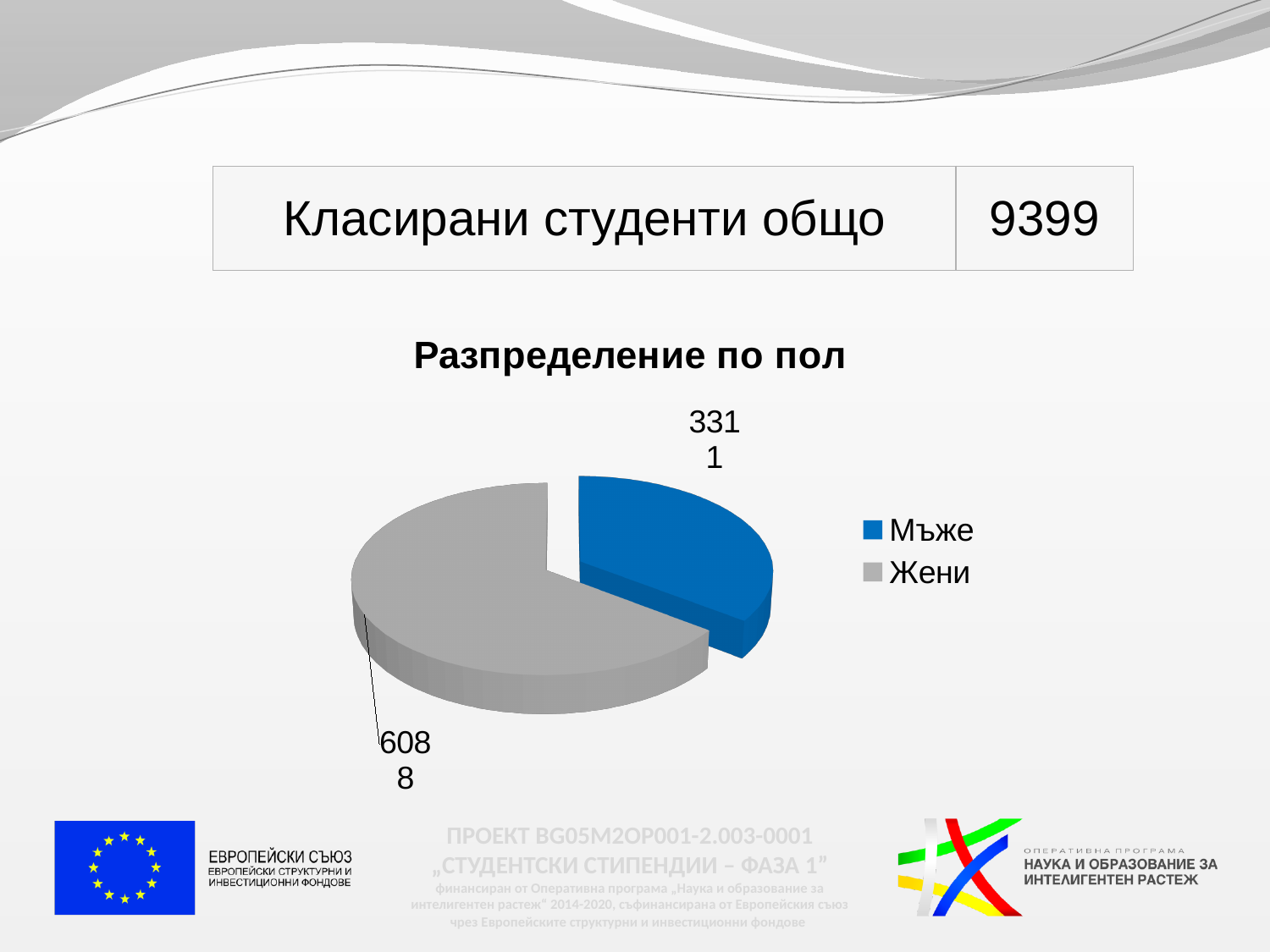
How many slices does the pie chart have? 2 How many categories does the legend of the chart list? 2 What type of chart is shown on the slide? pie chart What is the value for Мъже in the chart? 3311 What is the value for Жени in the chart? 6088 Which category has the smallest slice in the chart? Мъже Which is larger, the value for Мъже or the value for Жени? Жени Which category has the largest slice in the chart? Жени What is the difference between the values for Жени and Мъже? 2777 What is the title of the chart? Разпределение по пол Which colour represents Мъже in the chart? blue What is the total of the two slices in the chart? 9399